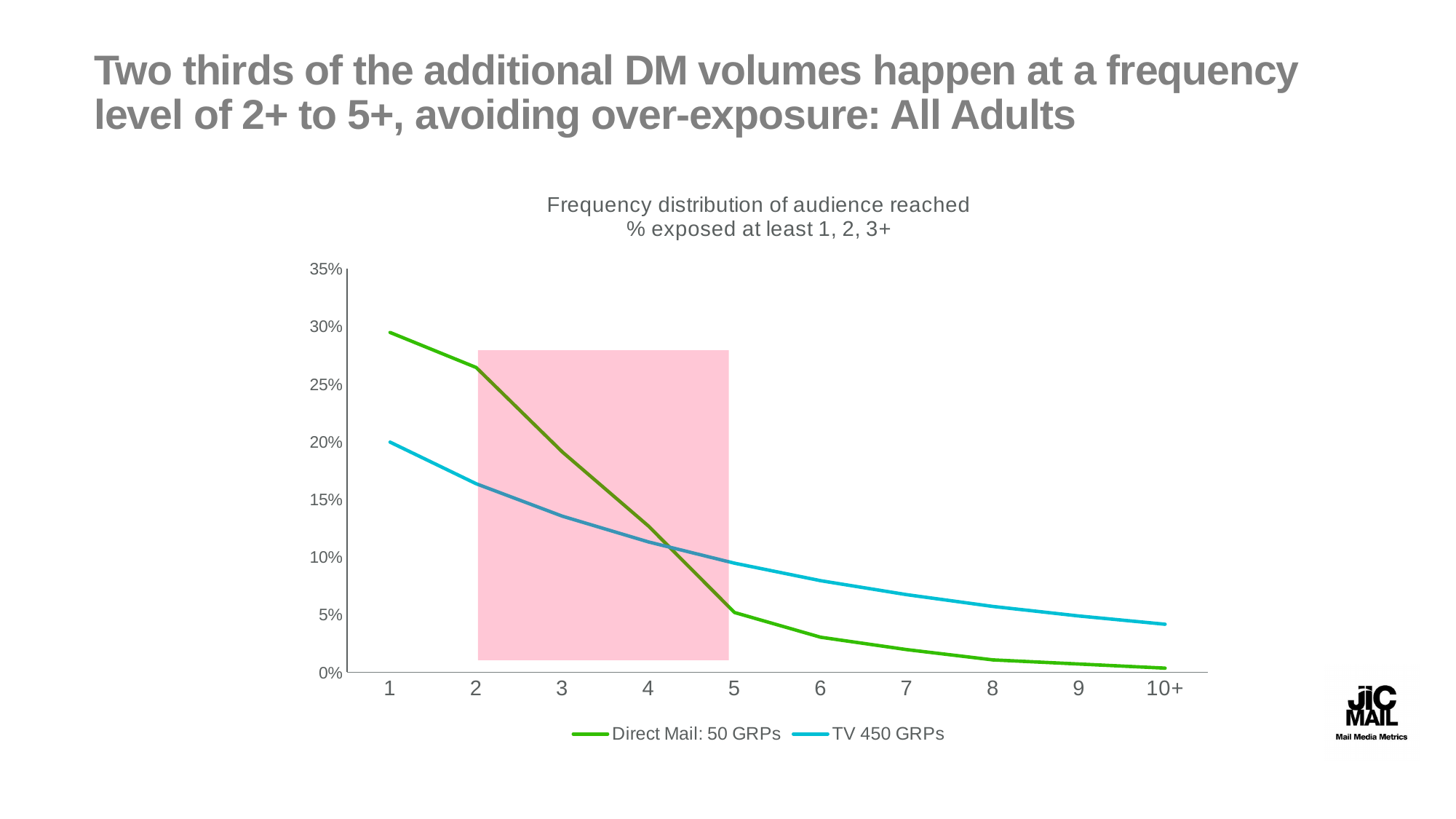
How many series does the legend list? 2 Is the value for Direct Mail: 50 GRPs at frequency 6 greater or less than 5%? less How many frequency categories are shown on the x axis? 10 At frequency 8, which series has the higher value: Direct Mail: 50 GRPs or TV 450 GRPs? TV 450 GRPs Do the values for Direct Mail: 50 GRPs rise or fall as frequency increases along the x axis? fall Is the value for TV 450 GRPs at frequency 10+ greater or less than 5%? less Is the value for TV 450 GRPs at frequency 6 greater or less than 10%? less What is the title of the chart? Frequency distribution of audience reached % exposed at least 1, 2, 3+ At frequency 1, which series has the higher value: Direct Mail: 50 GRPs or TV 450 GRPs? Direct Mail: 50 GRPs What kind of chart is shown on the slide? line chart